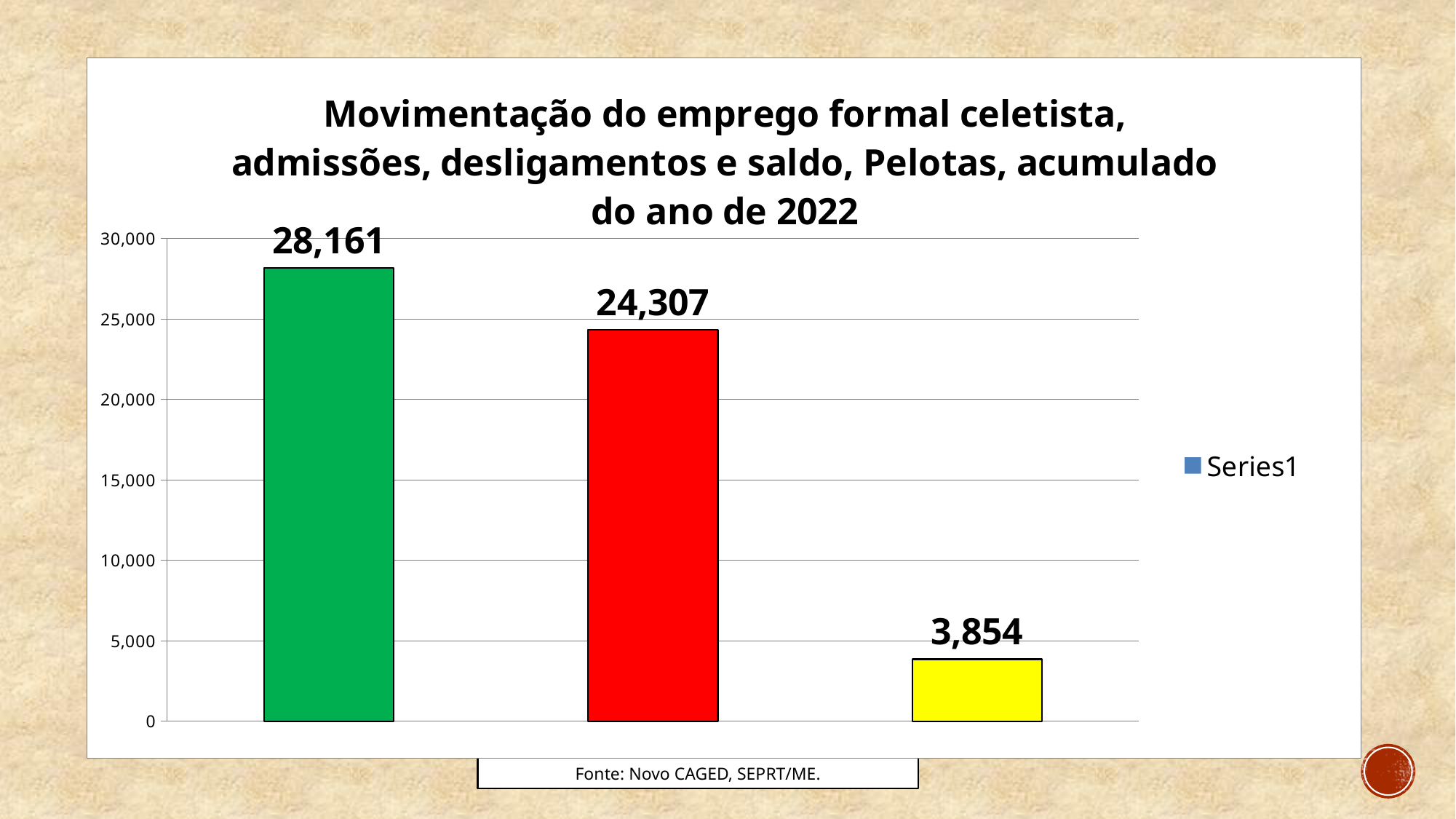
What kind of chart is shown on the slide? Bar chart How many bars are plotted in the chart? 3 What is the value shown on the green bar (the first bar from the left)? 28,161 What is the value shown on the yellow bar (the rightmost bar)? 3,854 How many series does the legend list? 1 Which bar has the lowest value? The yellow bar (3,854) What is the value shown on the red bar (the middle bar)? 24,307 Is the value of the yellow bar greater or less than 5,000? less Which is larger, the value of the green bar or the value of the red bar? The green bar What is the difference between the green bar's value and the red bar's value? 3,854 What is the difference between the red bar's value and the yellow bar's value? 20,453 Which bar has the highest value? The green bar (28,161)